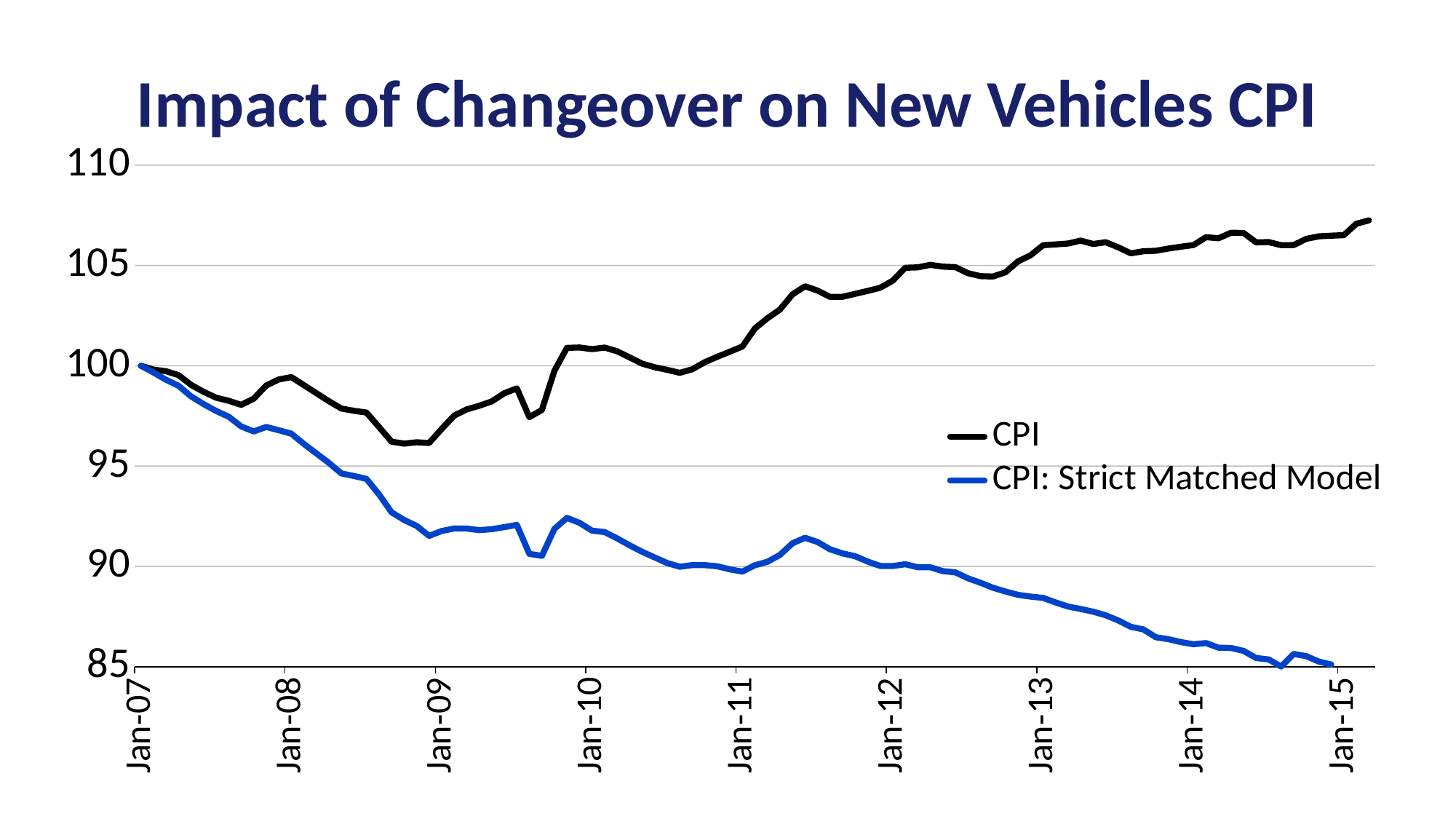
Is the value of the CPI series at Jan-09 greater or less than 100? less Is the value of the CPI: Strict Matched Model series at Jan-15 greater or less than 90? less Is the value of the CPI series at Jan-15 greater or less than 105? greater Does the CPI: Strict Matched Model series rise or fall overall from Jan-07 to Jan-15? fall What is the title of the chart? Impact of Changeover on New Vehicles CPI What is the value of the CPI: Strict Matched Model series at Jan-07? 100 What is the value of the CPI series at Jan-07? 100 What kind of chart is shown on the slide? line chart At Jan-15, which series has the higher value, CPI or CPI: Strict Matched Model? CPI How many series does the legend list? 2 Which series is drawn in blue? CPI: Strict Matched Model